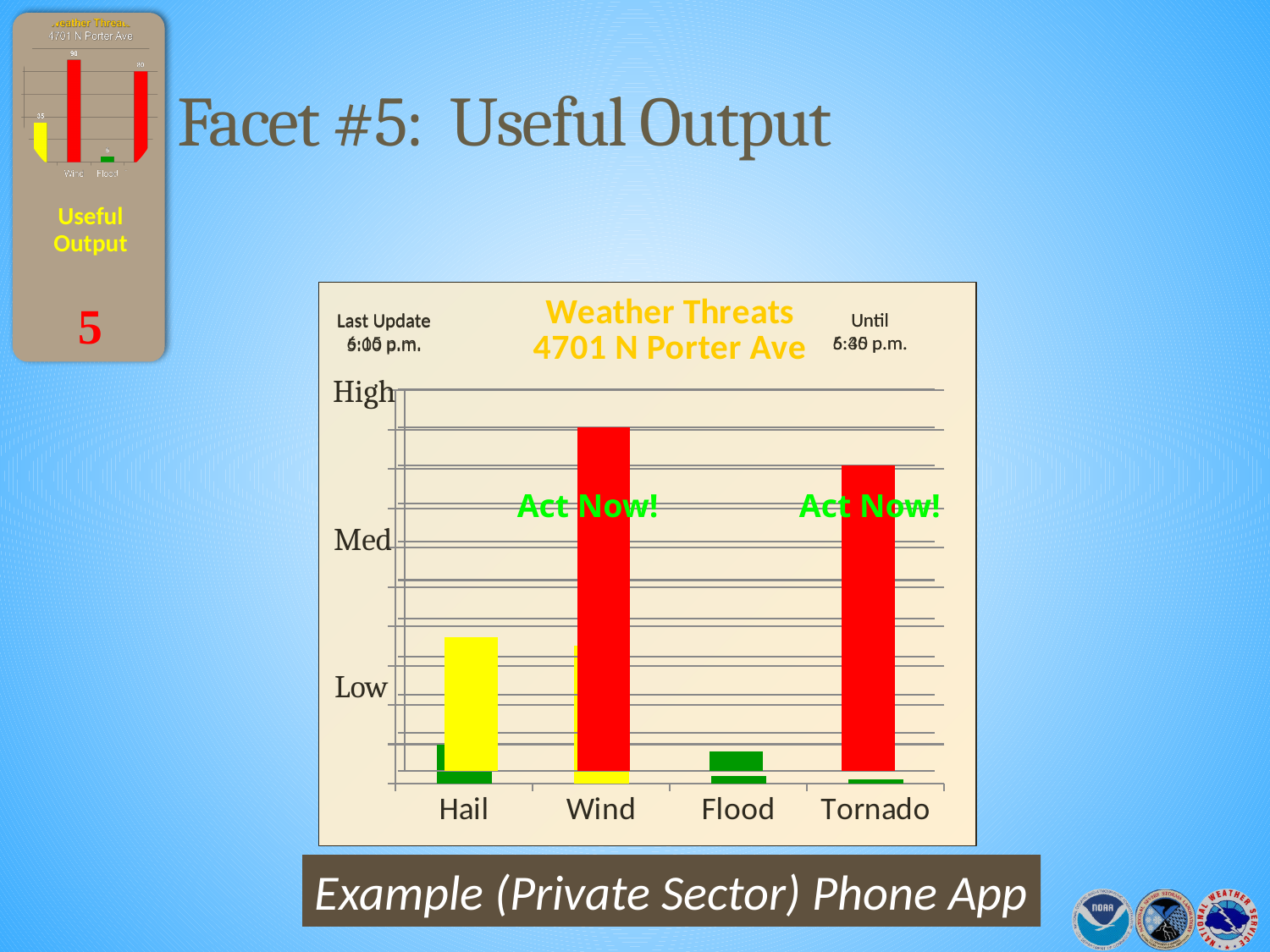
Is the bar for Hail above or below the Med line on the y axis? below Which has a higher bar, Hail or Tornado? Tornado Is the bar for Tornado above or below the Med line on the y axis? above Is the bar for Flood above or below the Low line on the y axis? below What is the title of the chart? Weather Threats 4701 N Porter Ave Which category has the highest bar in the Weather Threats chart? Wind Which has a higher bar, Wind or Tornado? Wind What kind of chart is shown on the slide? Bar chart Which category has the lowest bar in the Weather Threats chart? Flood Which two categories are labelled "Act Now!" in the chart? Wind and Tornado How many categories are shown on the x axis of the Weather Threats chart? 4 Which has a higher bar, Hail or Flood? Hail